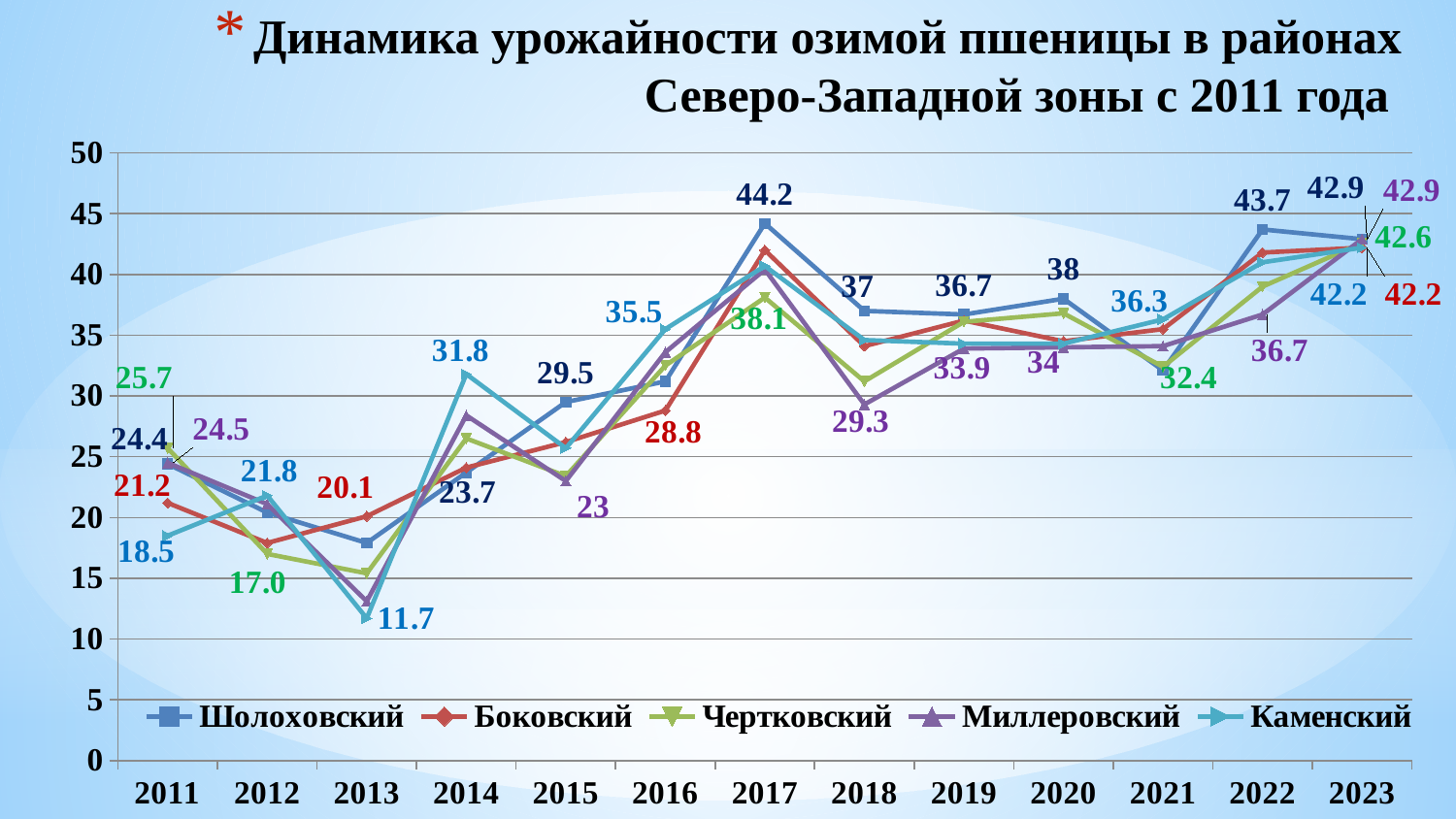
Is the value for Боковский in 2017 greater or less than 40? greater In 2011, which is larger: the value for Чертковский or for Каменский? Чертковский In which year does Шолоховский reach its highest value? 2017 What is the difference between the Каменский values in 2014 and 2013? 20.1 In which year does Каменский have its lowest value? 2013 How many years are shown on the x axis? 13 What is the value for Шолоховский in 2017? 44.2 What kind of chart is shown on the slide? Line chart What is the value for Чертковский in 2012? 17.0 How many series does the legend list? 5 What is the value for Каменский in 2013? 11.7 What is the value for Миллеровский in 2018? 29.3